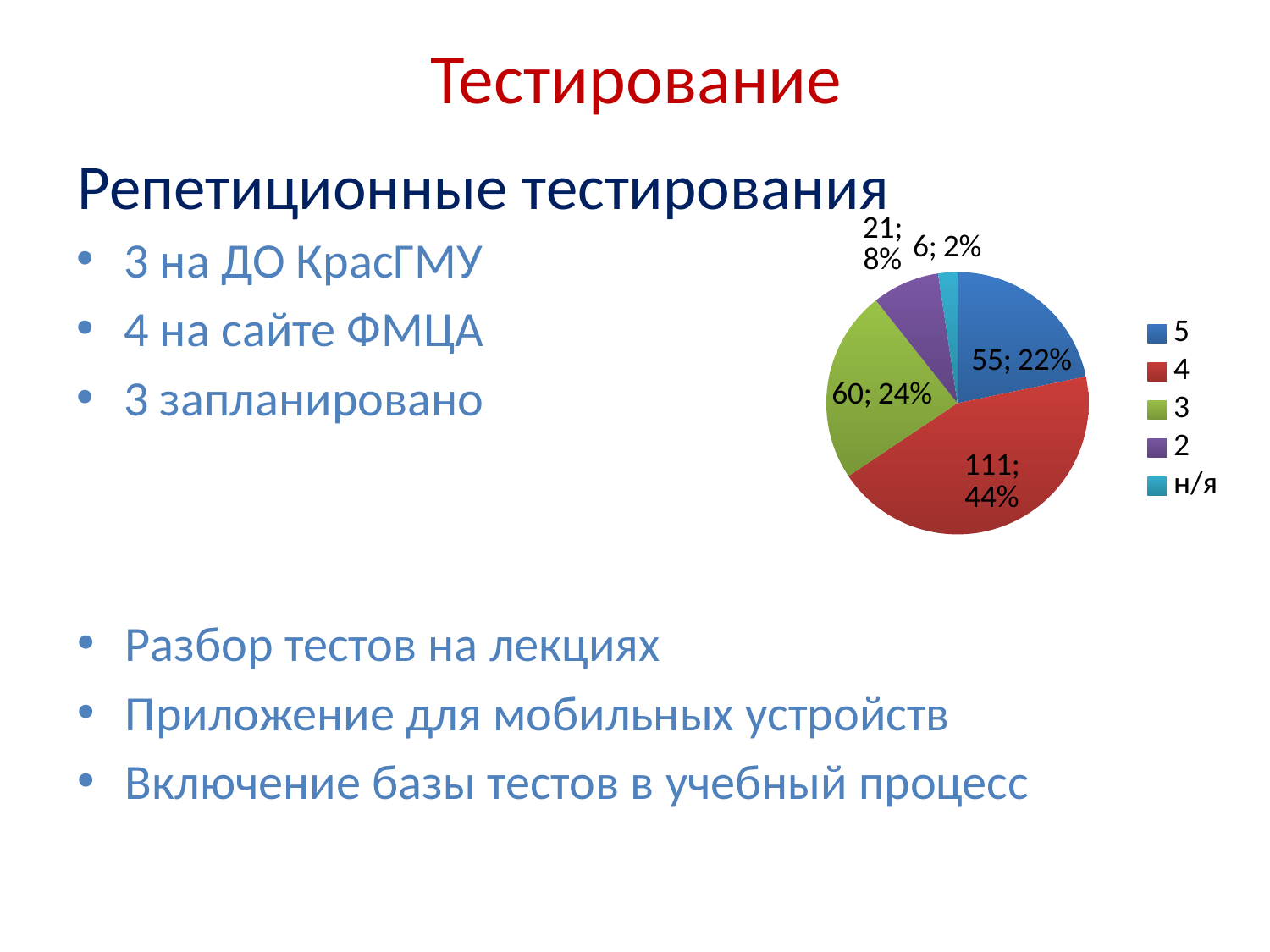
What is the value for category 3 in the pie chart? 60 What is the value for category 4 in the pie chart? 111 What is the difference between the values for category 4 and category 5? 56 How many slices does the pie chart have? 5 Which category has the smallest slice in the pie chart? н/я Which is larger, the value for category 3 or the value for category 5? 3 What share of the pie does category 3 represent? 24% What is the value for category н/я in the pie chart? 6 What kind of chart is shown on the slide? pie chart What share of the pie does category 2 represent? 8% What is the value for category 5 in the pie chart? 55 Which category has the largest slice in the pie chart? 4